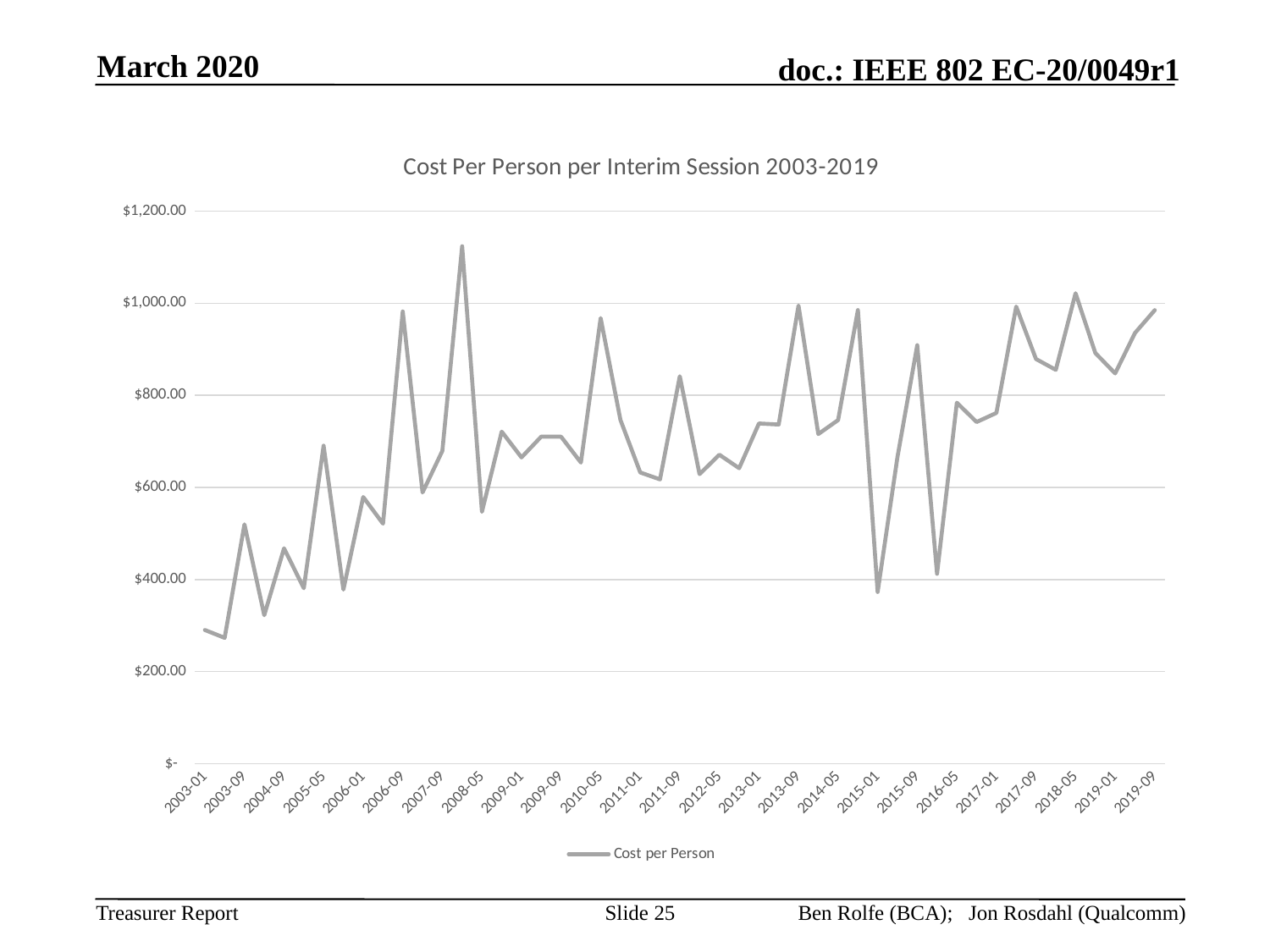
Is the value for 2019-09 greater or less than $800.00? greater Is the value for 2003-01 greater or less than $400.00? less Is the lowest point on the line greater or less than $400.00? less What kind of chart is shown on the slide? line chart What is the title of the chart? Cost Per Person per Interim Session 2003-2019 Overall, does the cost per person rise or fall from 2003 to 2019? rise What is the name of the series shown in the legend? Cost per Person How many series does the legend list? 1 Which is larger, the cost per person for 2003-01 or for 2019-09? 2019-09 What is the highest value shown on the vertical axis? $1,200.00